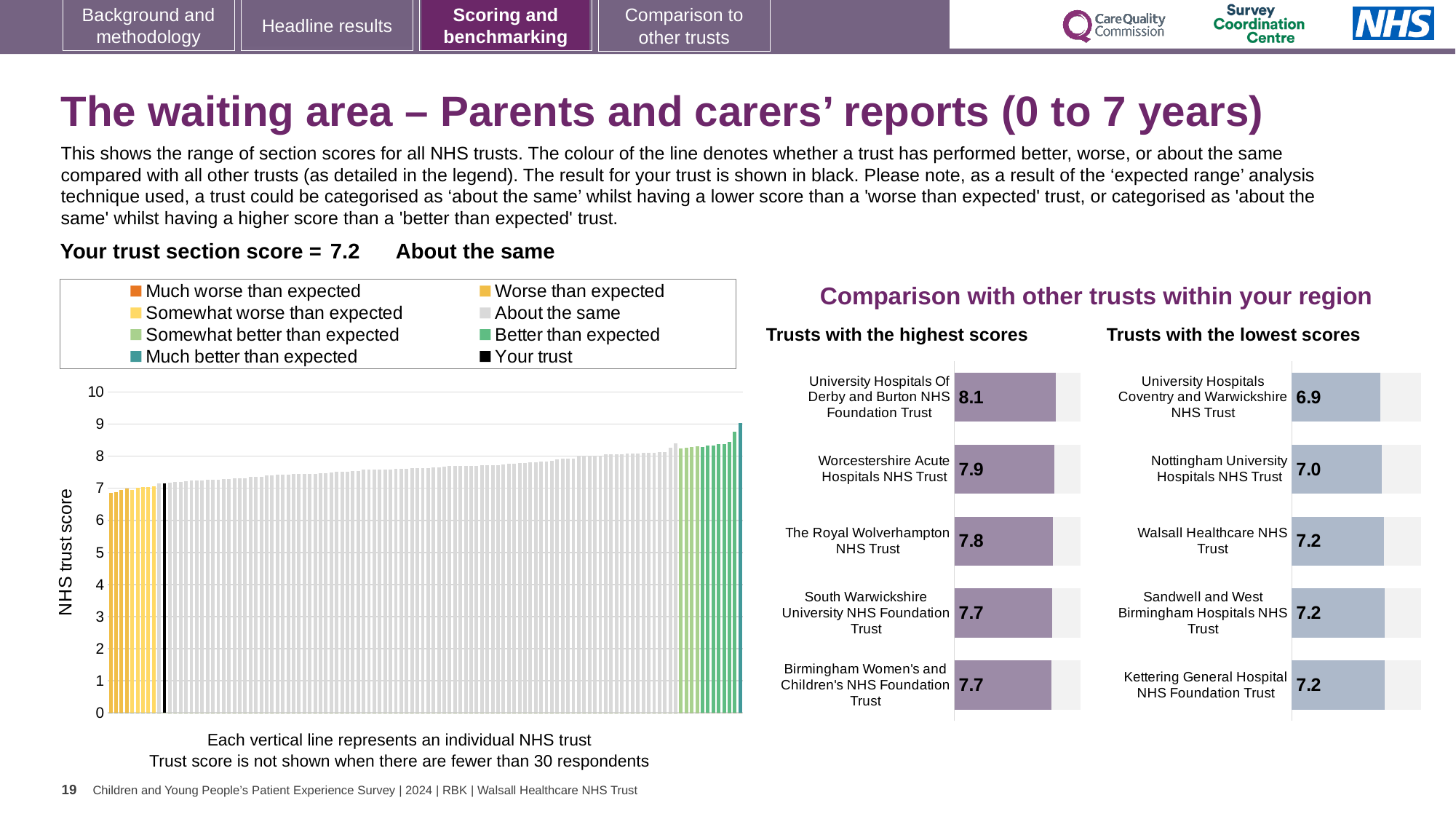
In the large chart on the left, is the value of the tallest bar greater or less than 8? greater How many trusts are shown in the 'Trusts with the highest scores' chart? 5 In the 'Trusts with the lowest scores' chart, what is the score for Walsall Healthcare NHS Trust? 7.2 In the 'Trusts with the highest scores' chart, what is the difference between the scores of University Hospitals Of Derby and Burton NHS Foundation Trust and Birmingham Women's and Children's NHS Foundation Trust? 0.4 In the 'Trusts with the highest scores' chart, which trust has the highest score? University Hospitals Of Derby and Burton NHS Foundation Trust In the 'Trusts with the highest scores' chart, what is the score for University Hospitals Of Derby and Burton NHS Foundation Trust? 8.1 In the 'Trusts with the lowest scores' chart, what is the difference between the scores of Kettering General Hospital NHS Foundation Trust and University Hospitals Coventry and Warwickshire NHS Trust? 0.3 What kind of chart is the large chart on the left showing the range of section scores for all NHS trusts? Bar chart In the 'Trusts with the highest scores' chart, what is the score for The Royal Wolverhampton NHS Trust? 7.8 In the 'Trusts with the lowest scores' chart, which trust has the lowest score? University Hospitals Coventry and Warwickshire NHS Trust In the 'Trusts with the lowest scores' chart, which has the larger score: Nottingham University Hospitals NHS Trust or University Hospitals Coventry and Warwickshire NHS Trust? Nottingham University Hospitals NHS Trust How many entries does the legend above the large chart on the left list? 8